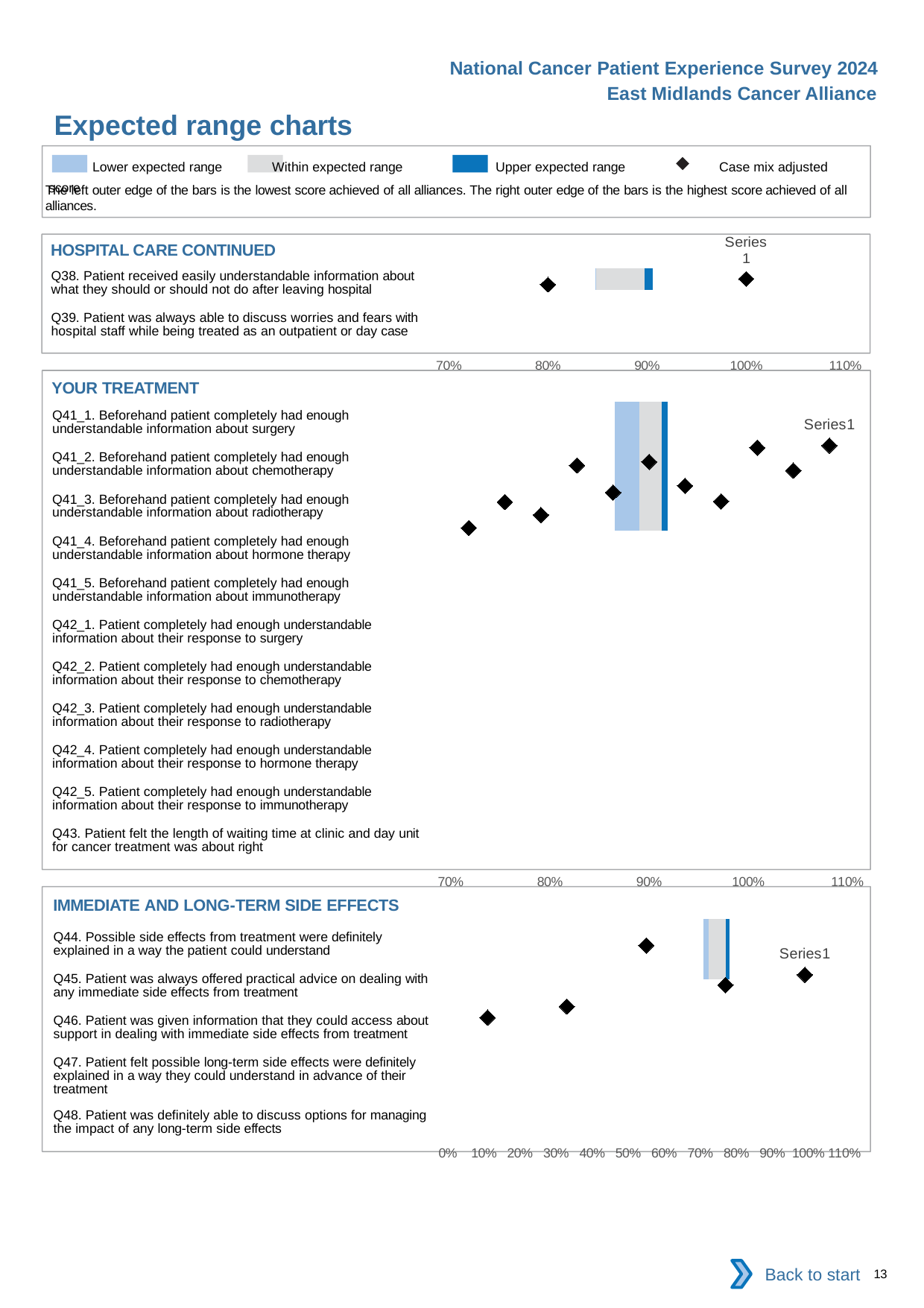
How many diamond markers are plotted in the YOUR TREATMENT chart? 11 How many questions (categories) are listed in the IMMEDIATE AND LONG-TERM SIDE EFFECTS chart? 5 How many questions (categories) are listed in the HOSPITAL CARE CONTINUED chart? 2 What is the title of the top chart on the slide? HOSPITAL CARE CONTINUED In the IMMEDIATE AND LONG-TERM SIDE EFFECTS chart, is the leftmost diamond marker greater or less than 20%? less What is the title of the bottom chart on the slide? IMMEDIATE AND LONG-TERM SIDE EFFECTS How many entries does the legend at the top of the slide list? 4 In the YOUR TREATMENT chart, is the leftmost diamond marker greater or less than 80%? less What is the lowest value shown on the x axis of the IMMEDIATE AND LONG-TERM SIDE EFFECTS chart? 0%